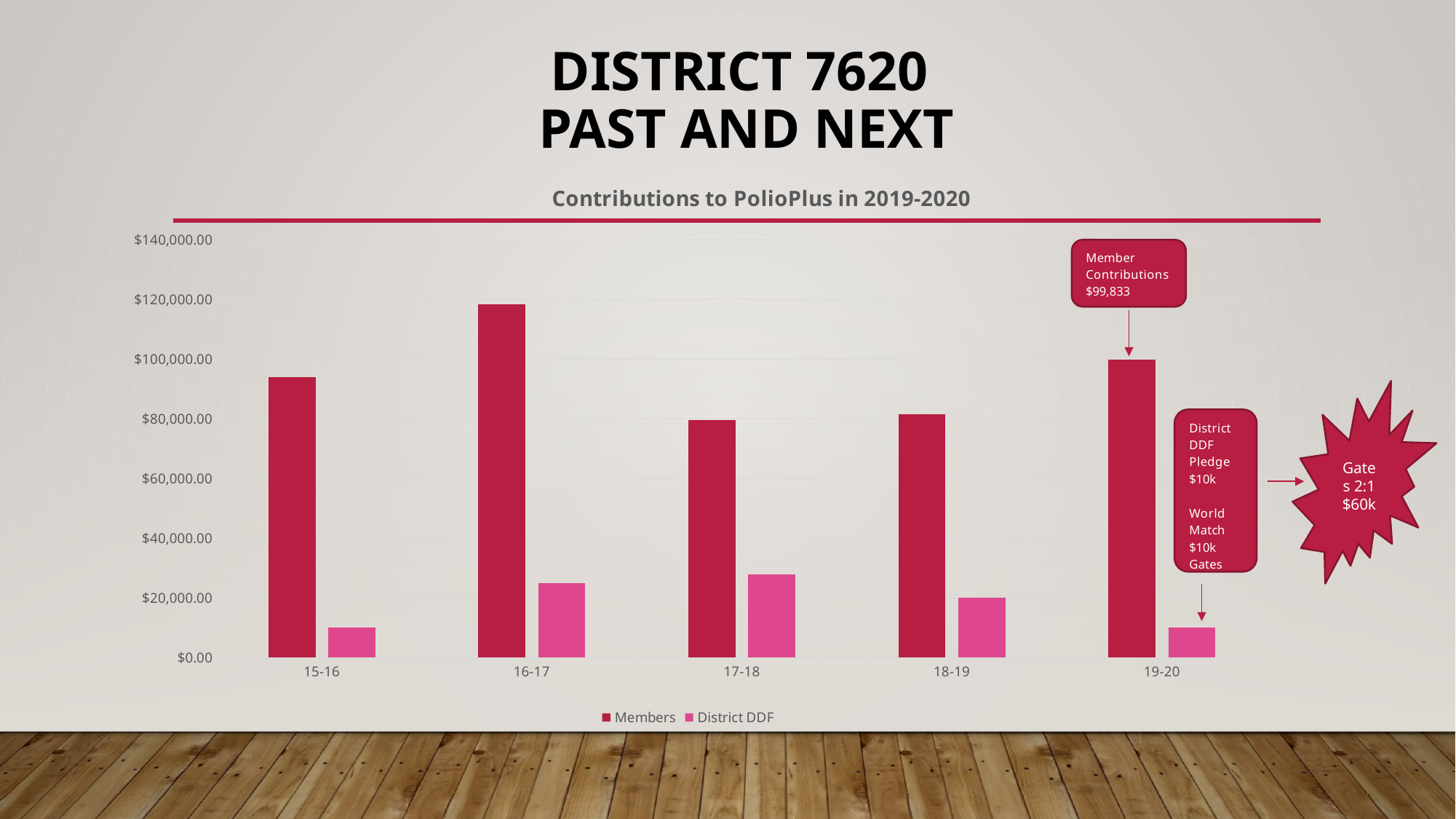
How many series does the chart legend list? 2 Do the Members contributions rise or fall from 16-17 to 17-18? fall What is the Member Contributions value for 19-20 according to the callout on the chart? $99,833 Is the Members value for 17-18 greater or less than $100,000.00? less How many year categories are shown on the x axis? 5 Is the Members value for 16-17 greater or less than $100,000.00? greater Which is larger, the Members value for 15-16 or the Members value for 16-17? 16-17 Is the District DDF value for 16-17 greater or less than $20,000.00? greater What is the title of the chart? Contributions to PolioPlus in 2019-2020 Which year has the highest Members contribution? 16-17 What kind of chart is shown on the slide? Bar chart